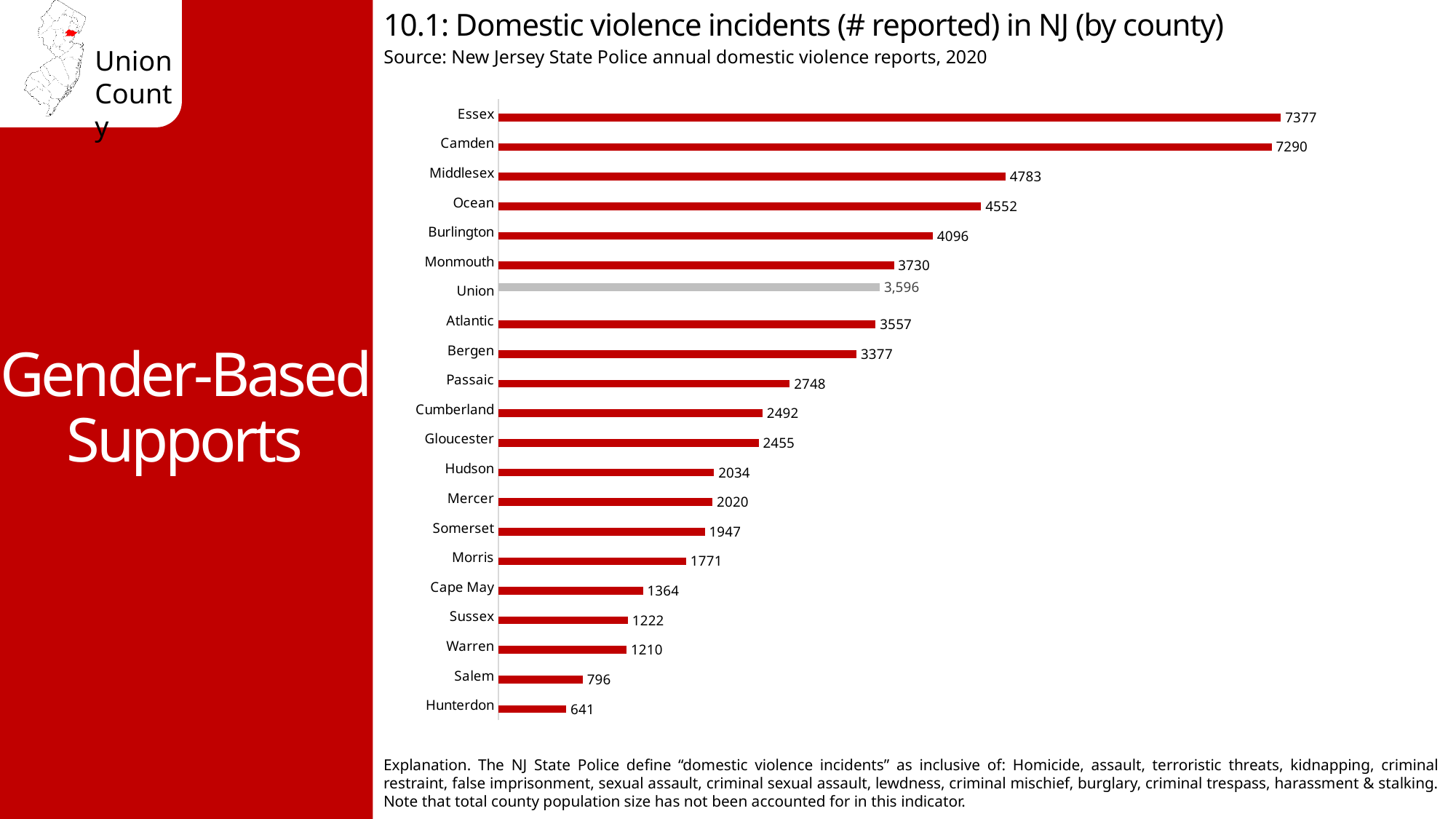
What kind of chart is shown on the slide? Bar chart Which county's bar is shown in grey rather than red? Union What is the difference between the values for Essex and Camden? 87 How many counties are shown in the chart? 21 Which county has the lowest number of reported domestic violence incidents? Hunterdon What is the number of reported domestic violence incidents for Union county? 3,596 Which county has more reported incidents, Monmouth or Atlantic? Monmouth Which county has more reported incidents, Salem or Cape May? Cape May What is the number of reported domestic violence incidents for Essex county? 7377 Which county has the highest number of reported domestic violence incidents? Essex What is the difference between the values for Middlesex and Ocean? 231 What is the number of reported domestic violence incidents for Hudson county? 2034